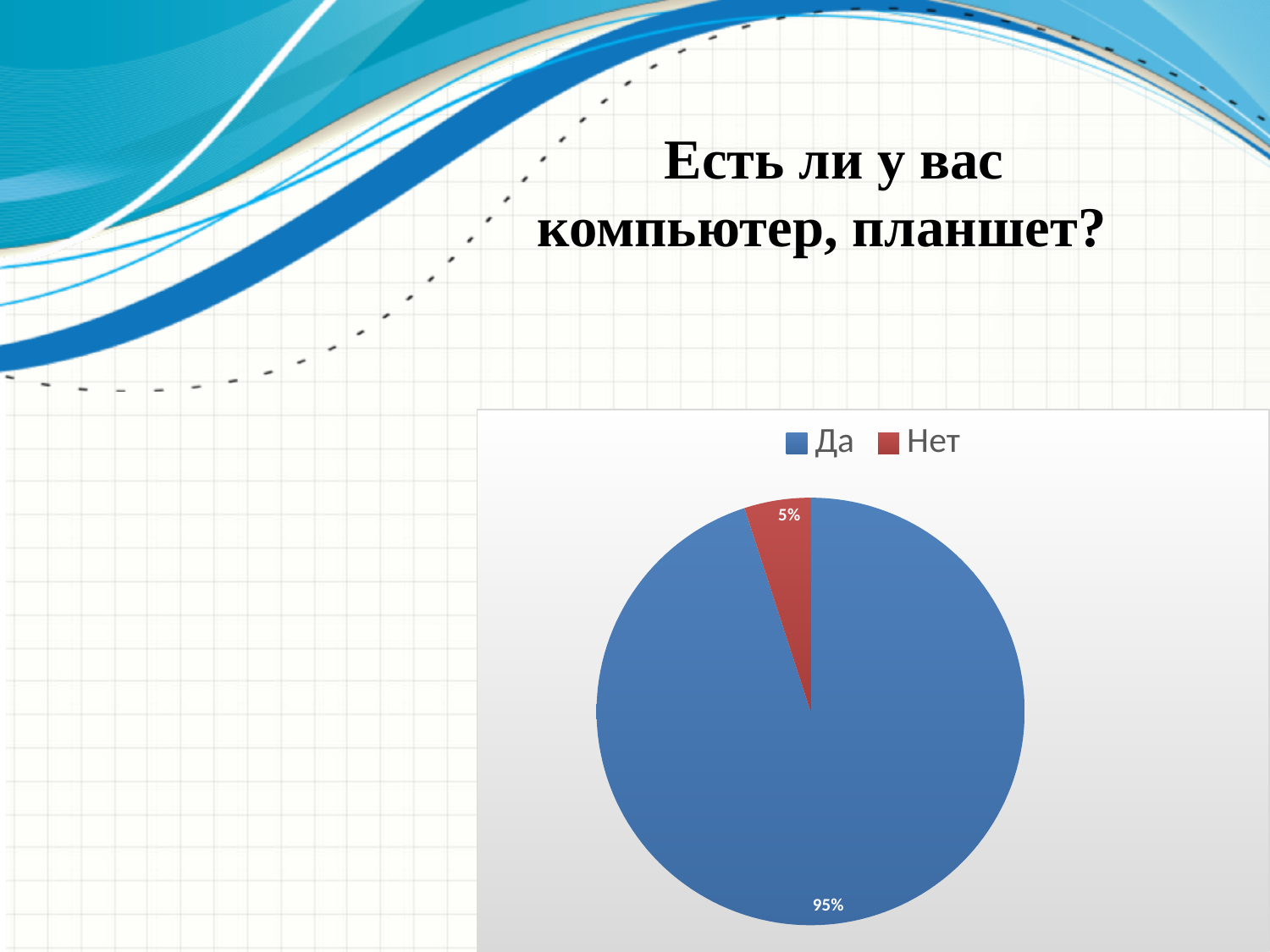
What kind of chart is shown on the slide? pie chart How many categories does the pie chart show? 2 What colour is the "Нет" slice? red What question is the chart on the slide answering, according to the slide title? Есть ли у вас компьютер, планшет? What is the difference in percentage points between the "Да" and "Нет" slices? 90 What share of the pie does "Нет" represent? 5% Which category has the largest slice of the pie? Да How many entries does the legend list? 2 Which slice is larger, "Да" or "Нет"? Да What share of the pie does "Да" represent? 95% Which category has the smallest slice of the pie? Нет